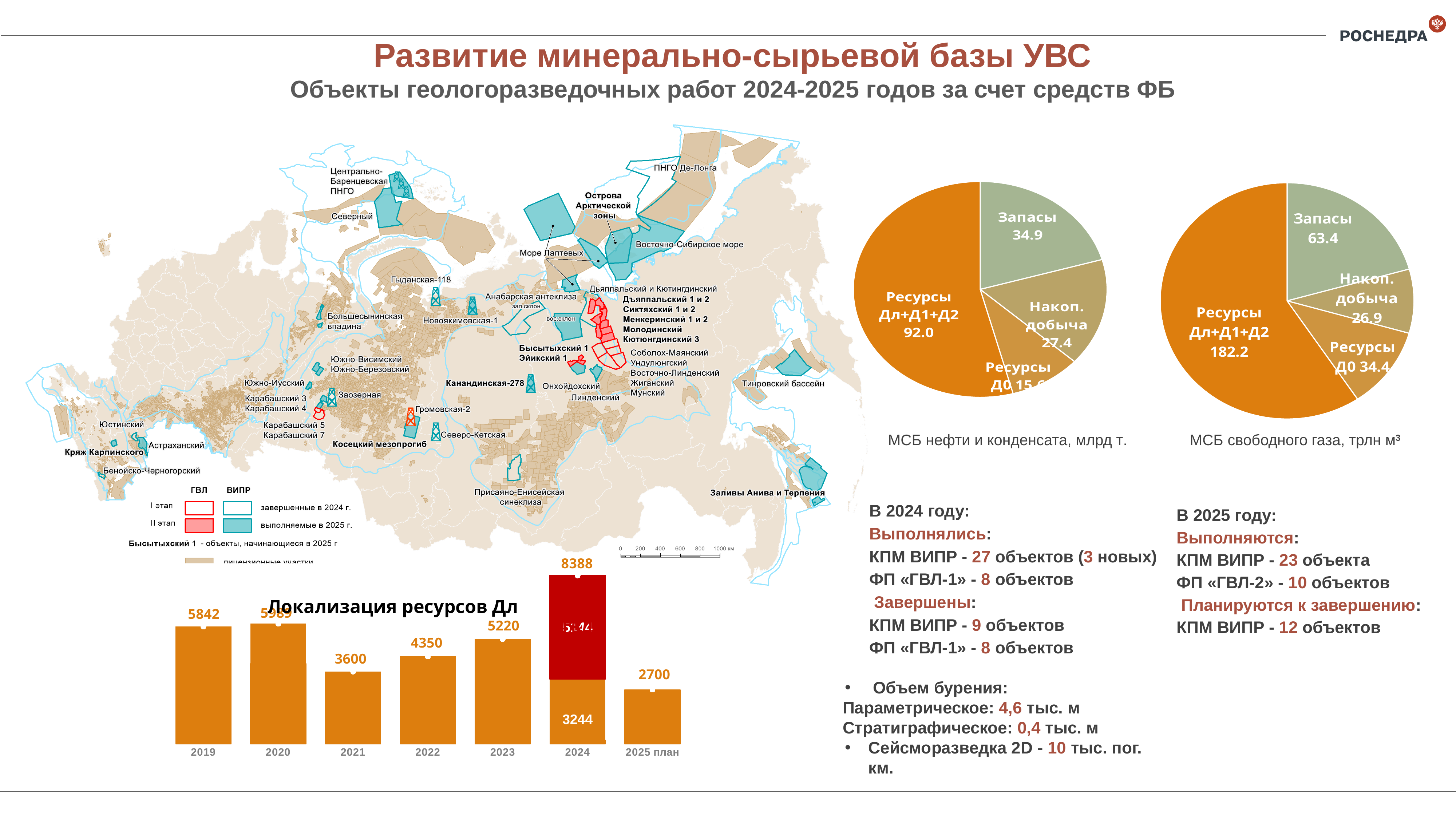
In the chart "Локализация ресурсов Дл", which is larger, the value for 2023 or the value for 2022? 2023 In the chart "Локализация ресурсов Дл", what is the value for 2019? 5842 In the chart "Локализация ресурсов Дл", what is the value for 2021? 3600 In the chart "Локализация ресурсов Дл", which year has the highest total value? 2024 In the chart "Локализация ресурсов Дл", what is the difference between the values for 2022 and 2021? 750 In the chart "Локализация ресурсов Дл", what is the value for 2025 план? 2700 What kind of chart is "Локализация ресурсов Дл"? bar chart In the chart "Локализация ресурсов Дл", which category has the lowest value? 2025 план In the pie chart "МСБ свободного газа, трлн м³", which slice is the largest? Ресурсы Дл+Д1+Д2 In the chart "Локализация ресурсов Дл", what is the total of the stacked bar for 2024? 8388 In the chart "Локализация ресурсов Дл", how many categories are shown on the x axis? 7 In the pie chart "МСБ нефти и конденсата, млрд т.", what is the value for Запасы? 34.9